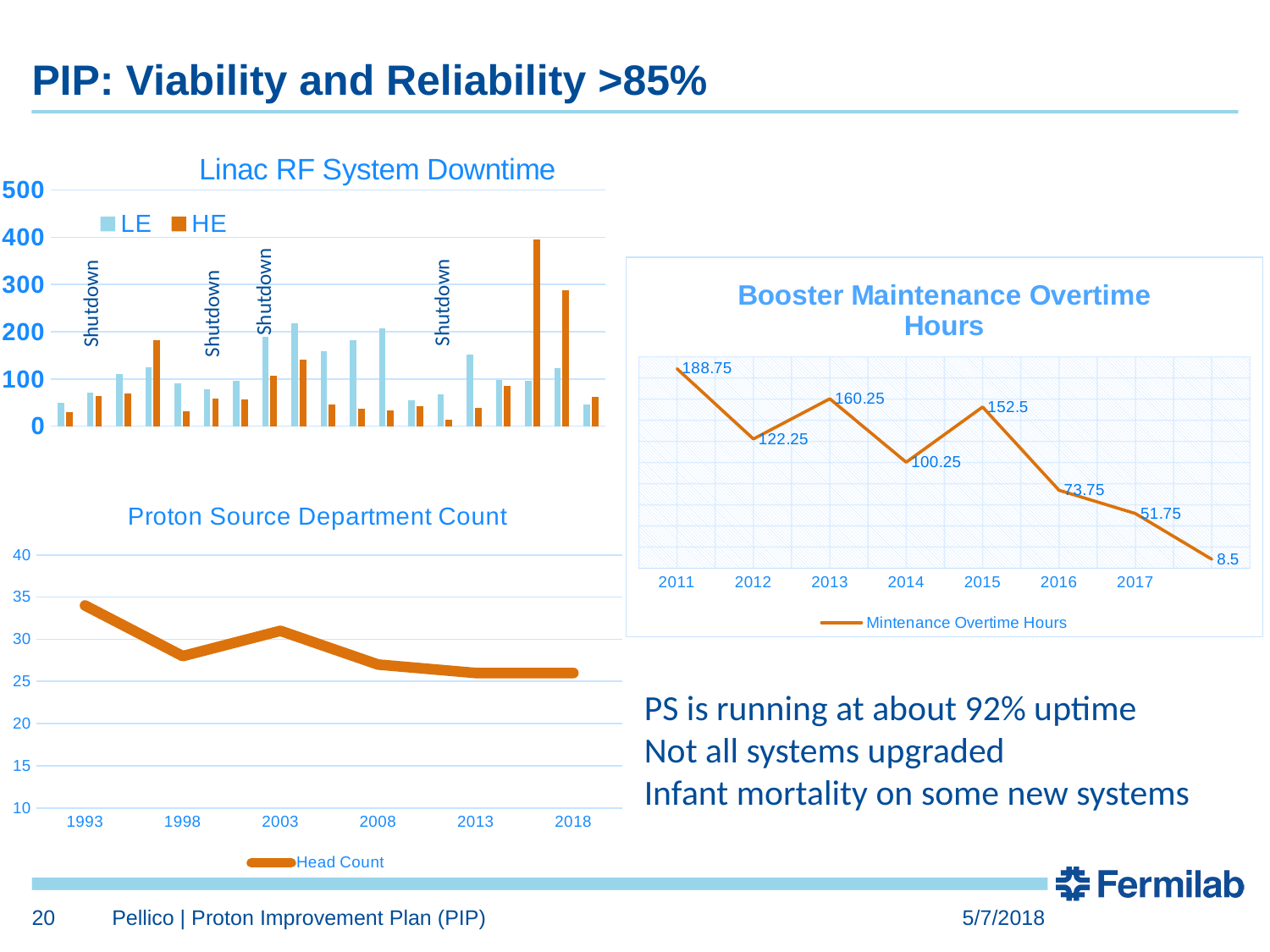
In the Booster Maintenance Overtime Hours chart, what is the value for 2011? 188.75 In the Proton Source Department Count chart, is the value for 1993 greater or less than 30? greater How many series does the legend of the Linac RF System Downtime chart list? 2 In the Proton Source Department Count chart, do the values generally rise or fall from 1993 to 2018? fall In the Booster Maintenance Overtime Hours chart, which is larger, the value for 2013 or the value for 2015? 2013 In the Proton Source Department Count chart, is the value for 2018 greater or less than 30? less In the Booster Maintenance Overtime Hours chart, how many years are labeled on the x axis? 7 In the Booster Maintenance Overtime Hours chart, what is the difference between the 2011 and 2012 values? 66.5 In the Booster Maintenance Overtime Hours chart, what is the lowest value shown on the line? 8.5 What kind of chart is the Linac RF System Downtime chart? bar chart In the Booster Maintenance Overtime Hours chart, what is the value for 2014? 100.25 In the Booster Maintenance Overtime Hours chart, which year has the highest value? 2011